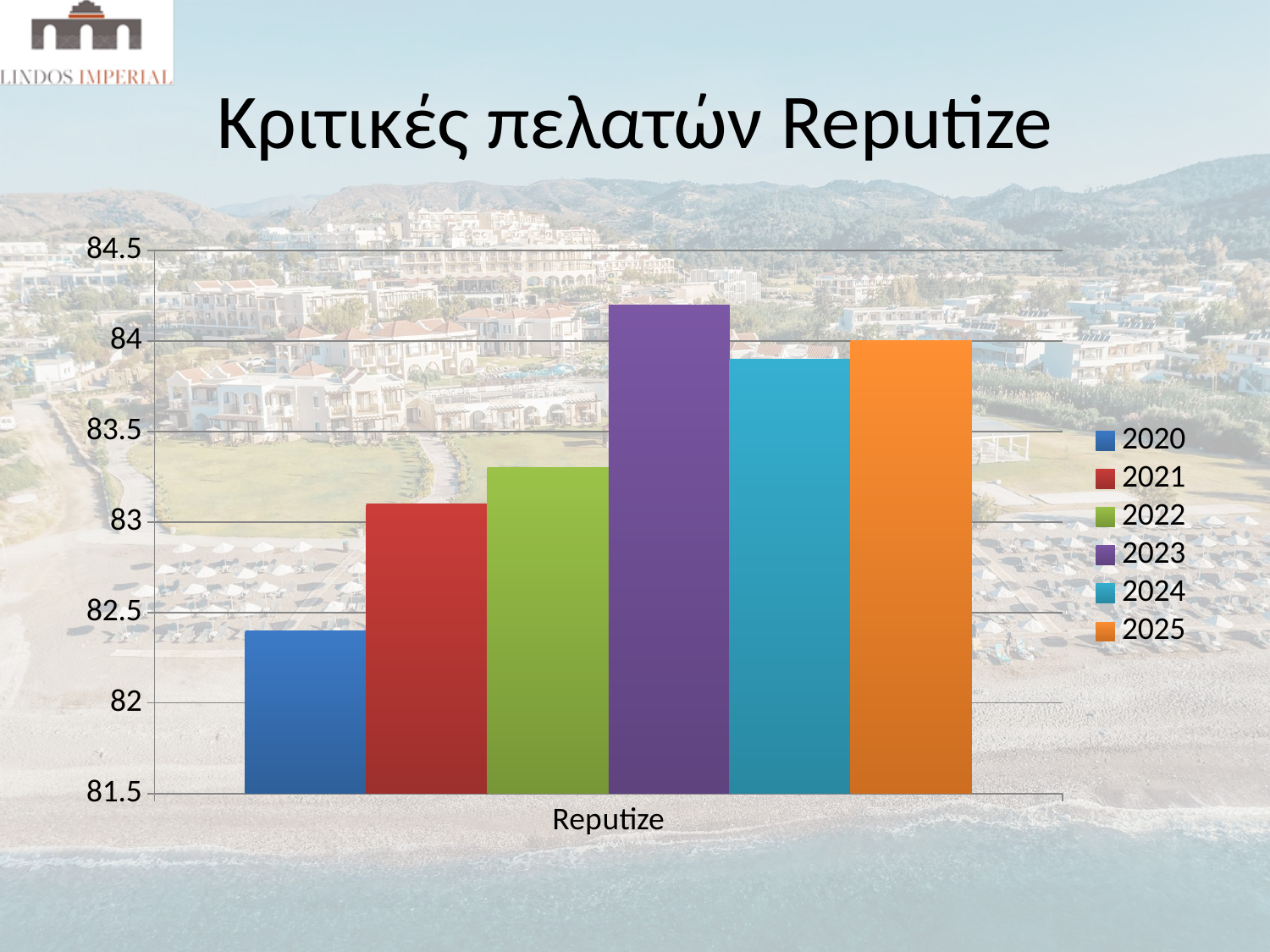
How many series does the legend list? 6 Which year has the lowest value? 2020 What kind of chart is shown on the slide? bar chart What is the title of the slide? Κριτικές πελατών Reputize Is the value for 2021 greater or less than 83? greater Which year has the highest value? 2023 Which is larger, the value for 2020 or the value for 2021? 2021 Is the value for 2023 greater or less than 84? greater Is the value for 2022 greater or less than 83.5? less What is the label of the category on the x axis? Reputize How many categories are shown on the x axis? 1